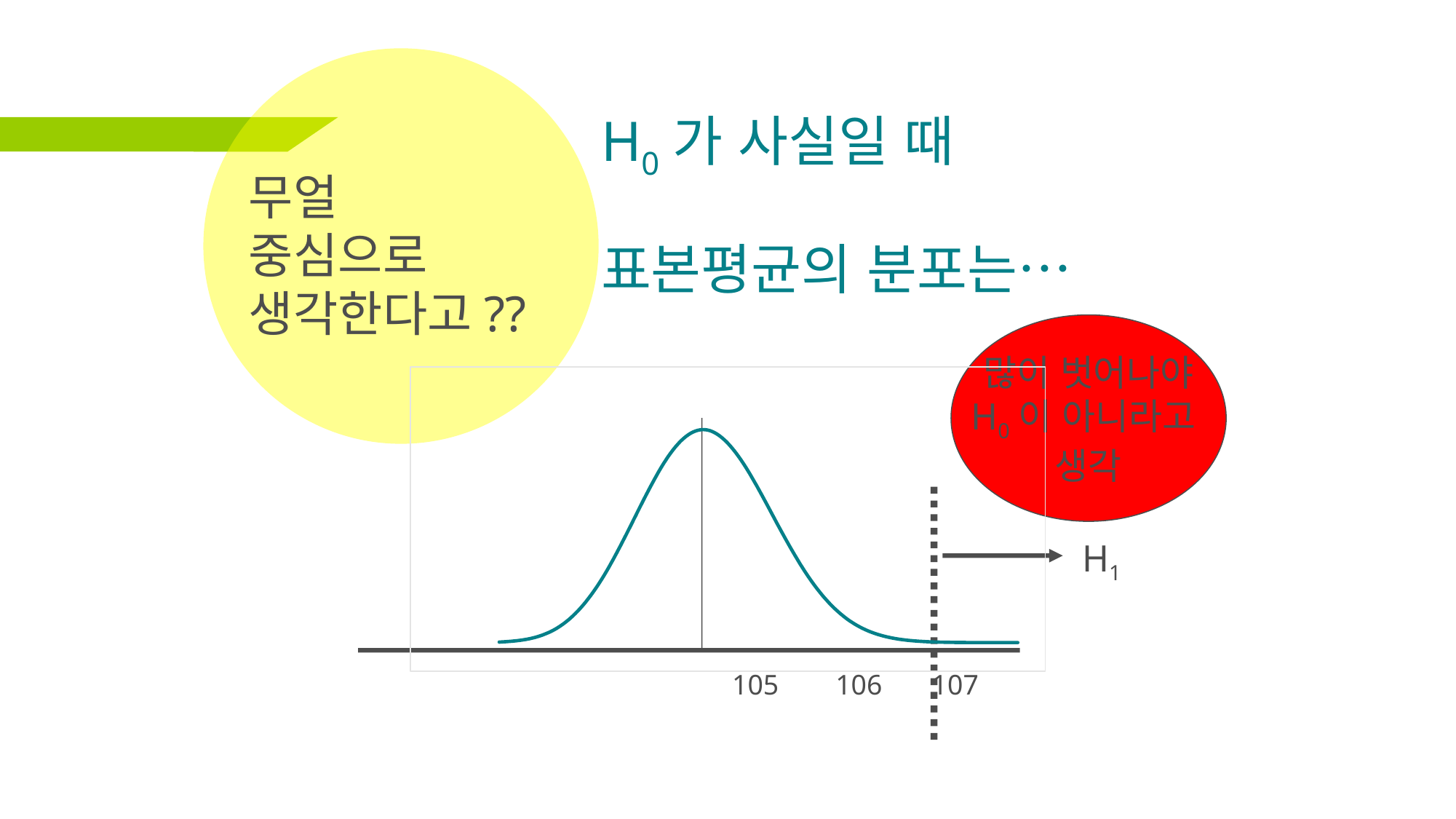
Does the curve rise or fall as the x axis moves from 105 to 107? falls What is the largest tick label printed on the x axis of the chart? 107 How many tick labels are printed along the x axis of the chart? 3 What are the tick labels printed along the x axis of the chart? 105, 106, 107 Is the height of the curve at 107 greater or less than its height at 105? less What kind of chart is shown on the slide? line chart What is the smallest tick label printed on the x axis of the chart? 105 What label is written at the end of the arrow pointing right from the dotted line? H1 Which x-axis tick label is the dotted vertical line closest to? 107 What colour is the curve plotted on the chart? teal